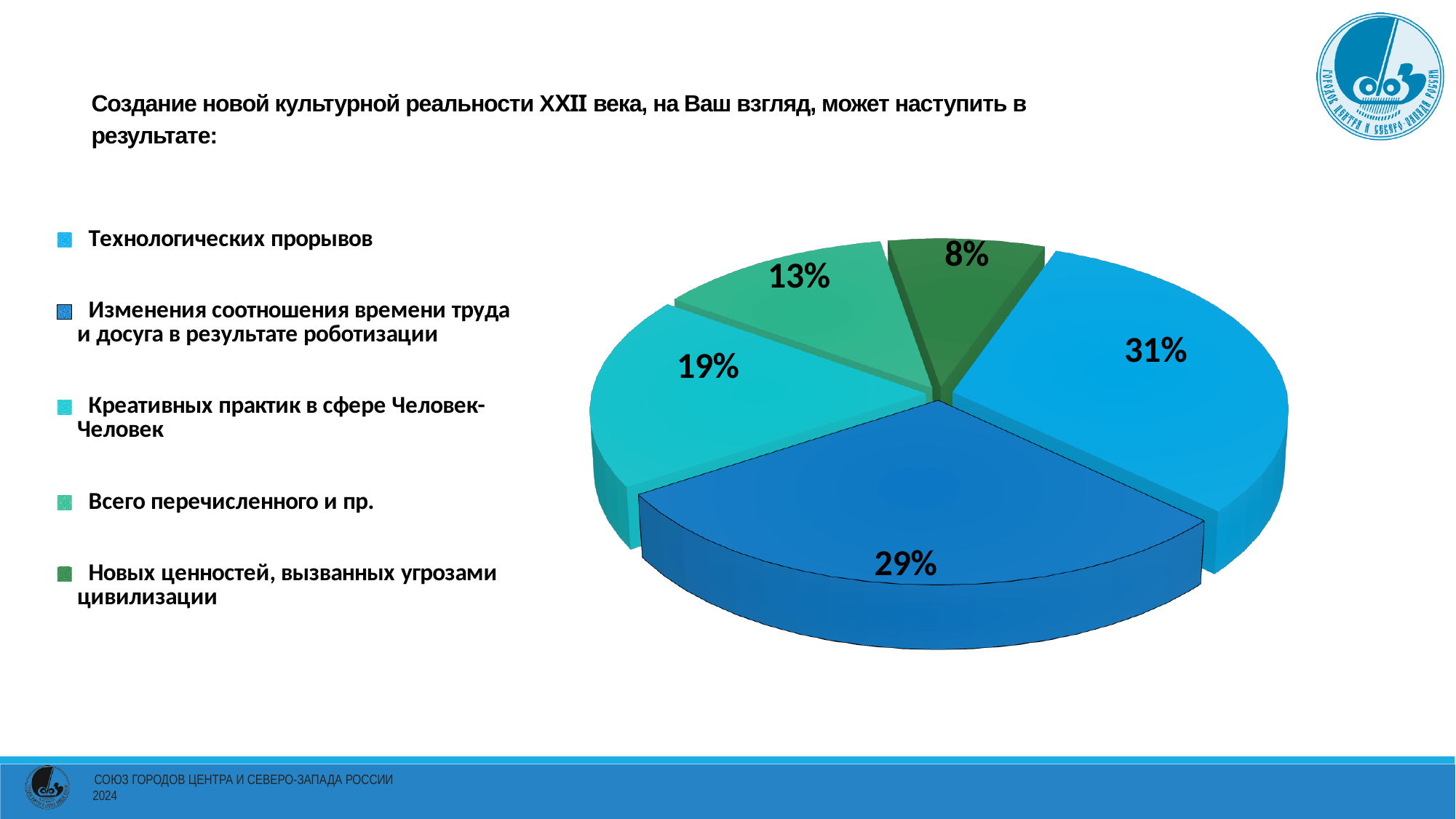
What is the difference between the values for "Технологических прорывов" and "Изменения соотношения времени труда и досуга в результате роботизации"? 2% Which category has the smallest slice of the pie? Новых ценностей, вызванных угрозами цивилизации How many slices does the pie chart have? 5 What is the value for "Изменения соотношения времени труда и досуга в результате роботизации"? 29% What kind of chart is shown on the slide? pie chart Which category has the largest slice of the pie? Технологических прорывов What colour is the slice for "Новых ценностей, вызванных угрозами цивилизации"? dark green What share of the pie does "Технологических прорывов" have? 31% What is the value for "Креативных практик в сфере Человек-Человек"? 19% What is the value for "Новых ценностей, вызванных угрозами цивилизации"? 8% Which is larger: the value for "Креативных практик в сфере Человек-Человек" or the value for "Всего перечисленного и пр."? Креативных практик в сфере Человек-Человек What is the value for "Всего перечисленного и пр."? 13%